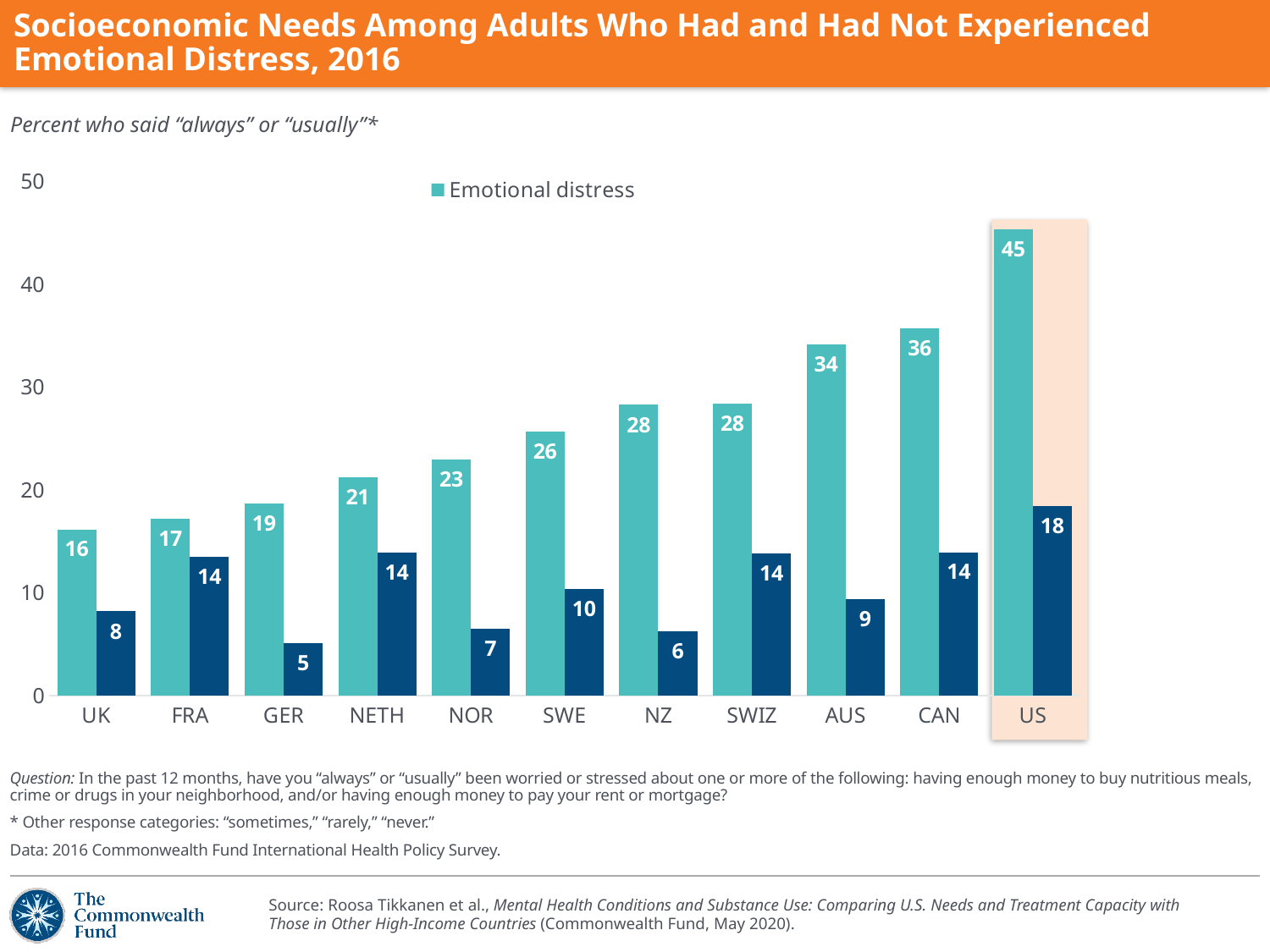
Which country has the lowest Emotional distress value? UK How many countries are shown on the x axis? 11 What kind of chart is shown on the slide? Bar chart What is the value of the dark blue bar for GER? 5 Which country has the highest Emotional distress value? US What series name is listed in the chart legend? Emotional distress What is the Emotional distress value for NETH? 21 What is the difference between the Emotional distress values for the US and CAN? 9 What is the Emotional distress value for SWIZ? 28 Which has a larger Emotional distress value, AUS or SWE? AUS Do the Emotional distress values rise or fall from UK to US along the x axis? Rise What is the Emotional distress value for the US? 45